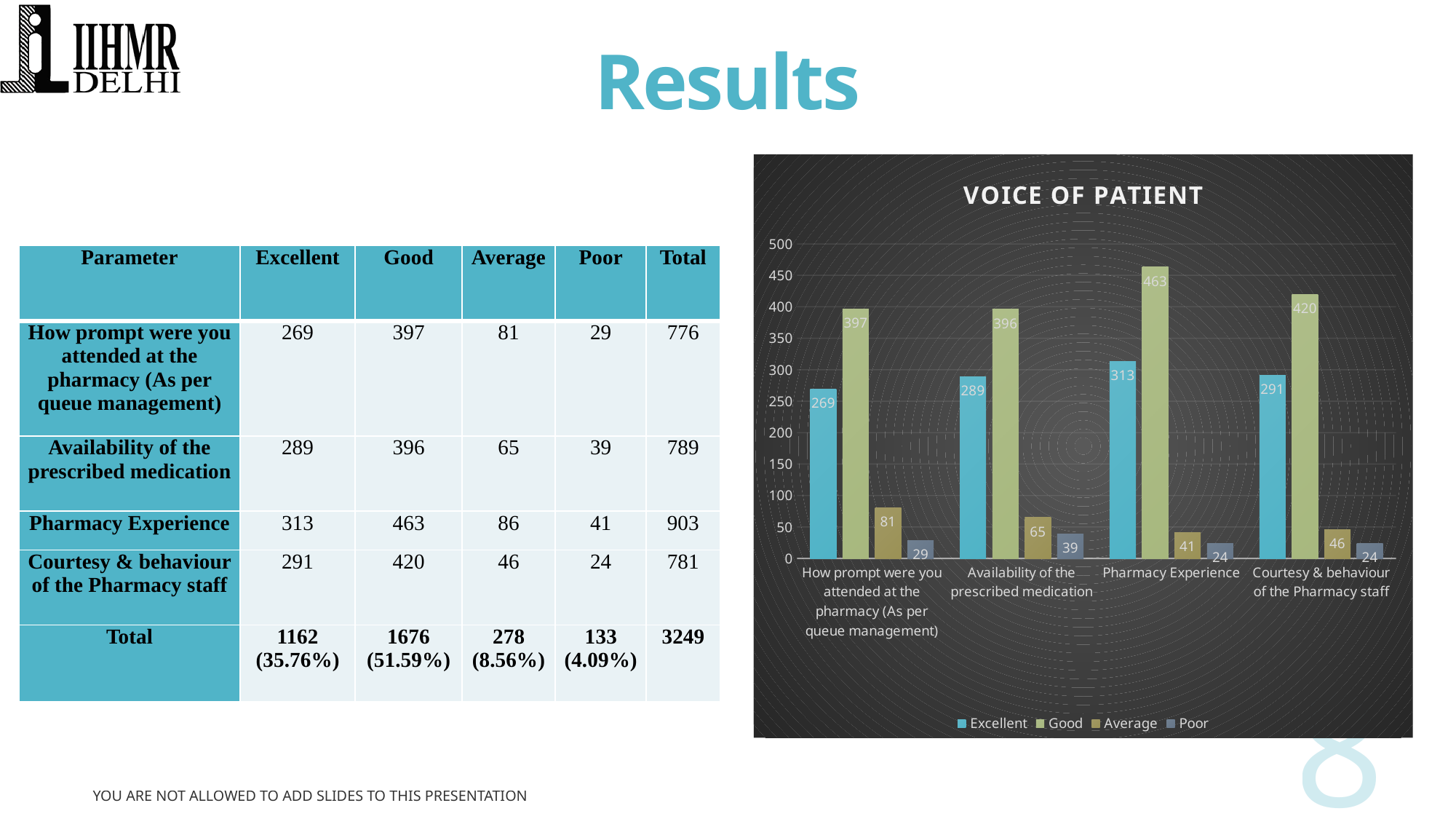
Which is larger, the Average value for the queue management category or the Average value for Pharmacy Experience? How prompt were you attended at the pharmacy (As per queue management) Which category has the lowest Average value? Pharmacy Experience Is the Excellent value for Pharmacy Experience greater or less than 300? greater How many series does the chart legend list? 4 What is the Good value for Pharmacy Experience? 463 What is the Excellent value for Availability of the prescribed medication? 289 What is the title of the chart? VOICE OF PATIENT Which category has the highest Good value? Pharmacy Experience What type of chart is shown on the slide? bar chart What is the difference between the Good and Excellent values for Courtesy & behaviour of the Pharmacy staff? 129 How many categories are shown on the x axis of the chart? 4 What is the Poor value for Courtesy & behaviour of the Pharmacy staff? 24